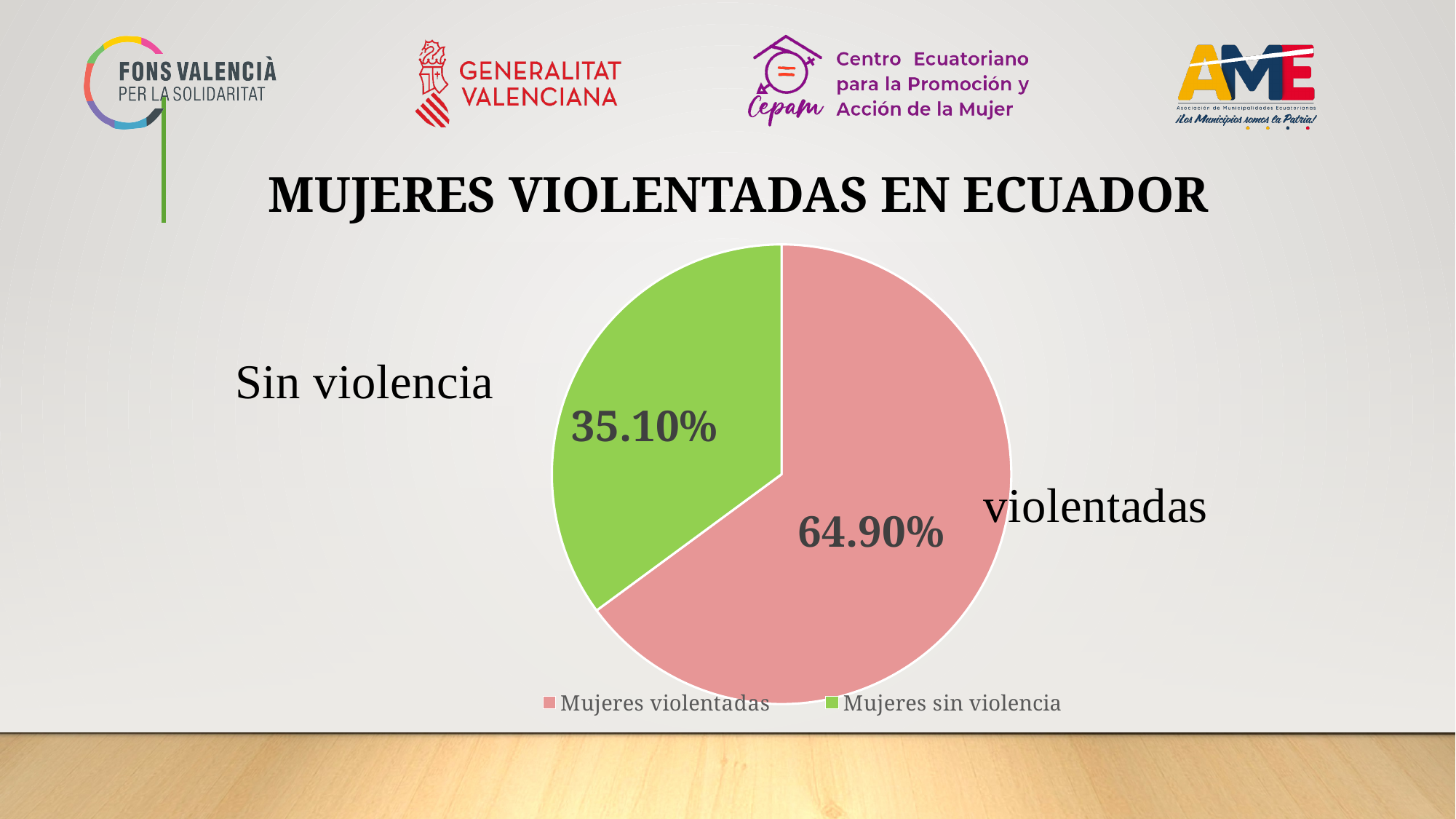
Which is larger, the share for Mujeres violentadas or for Mujeres sin violencia? Mujeres violentadas Which slice of the pie is the smallest? Mujeres sin violencia What kind of chart is shown on the slide? Pie chart How many entries does the legend list? 2 Which slice of the pie is the largest? Mujeres violentadas What is the title of the slide above the chart? MUJERES VIOLENTADAS EN ECUADOR What percentage is shown for Mujeres sin violencia? 35.10% How many slices does the pie chart have? 2 What percentage is shown for Mujeres violentadas? 64.90% What is the difference in percentage points between Mujeres violentadas and Mujeres sin violencia? 29.80 What share of the pie does the Mujeres violentadas slice represent? 64.90% What colour is the slice for Mujeres sin violencia? Green